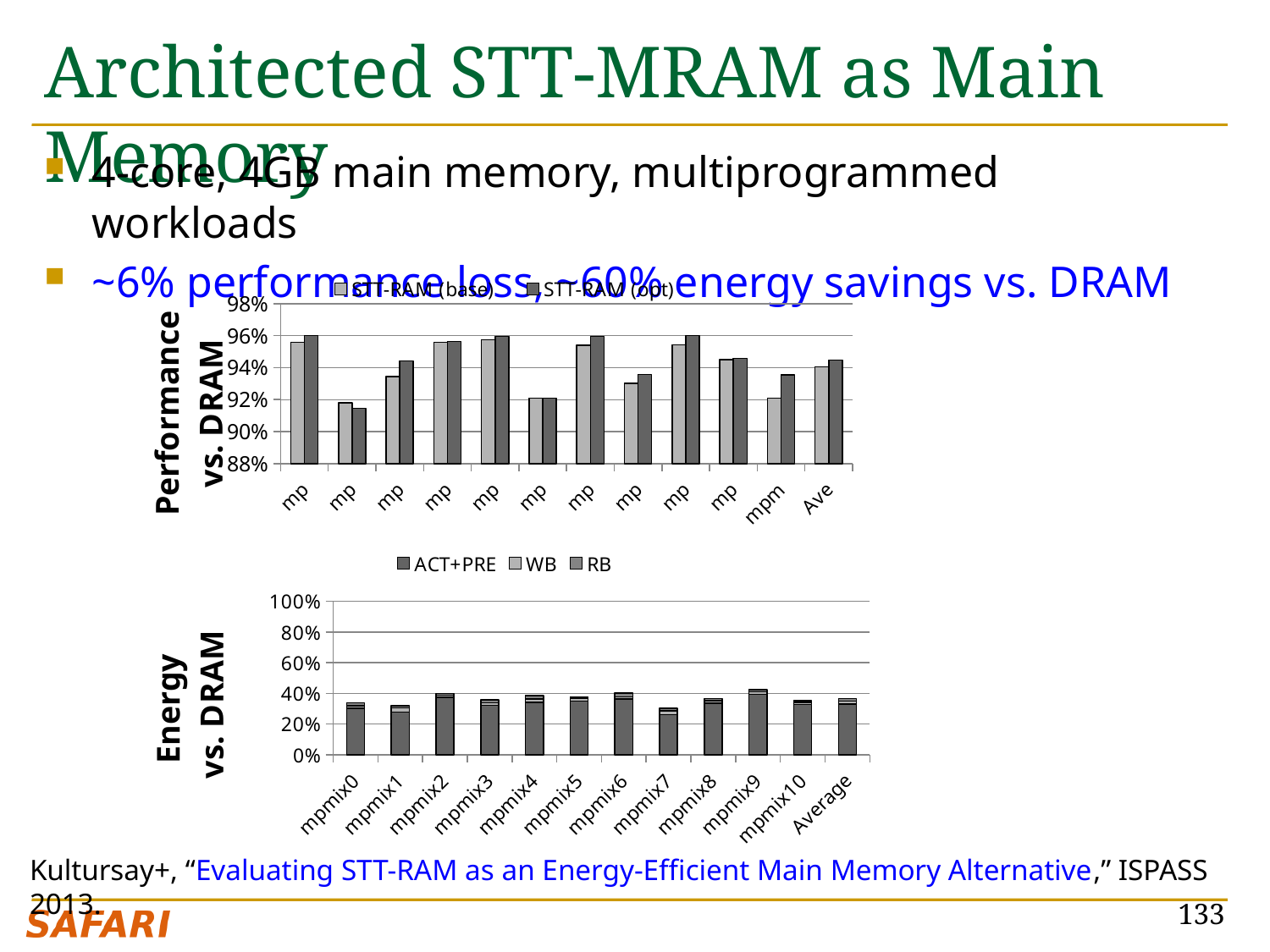
In the Energy vs. DRAM chart, what are the series named in the legend? ACT+PRE, WB, RB What kind of chart is the Performance vs. DRAM chart at the top of the slide? bar chart In the Performance vs. DRAM chart, what are the two series named in the legend? STT-RAM (base) and STT-RAM (opt) In the Energy vs. DRAM chart, is the total bar for mpmix9 greater or less than 60%? less In the Performance vs. DRAM chart, is the STT-RAM (opt) value for Ave greater or less than 92%? greater In the Energy vs. DRAM chart, which total bar is larger, mpmix9 or mpmix7? mpmix9 How many series does the legend of the Performance vs. DRAM chart list? 2 What kind of chart is the Energy vs. DRAM chart at the bottom of the slide? stacked bar chart How many series does the legend of the Energy vs. DRAM chart list? 3 How many categories are shown on the x axis of the Energy vs. DRAM chart? 12 In the Performance vs. DRAM chart, is the STT-RAM (opt) value for Ave greater or less than 96%? less